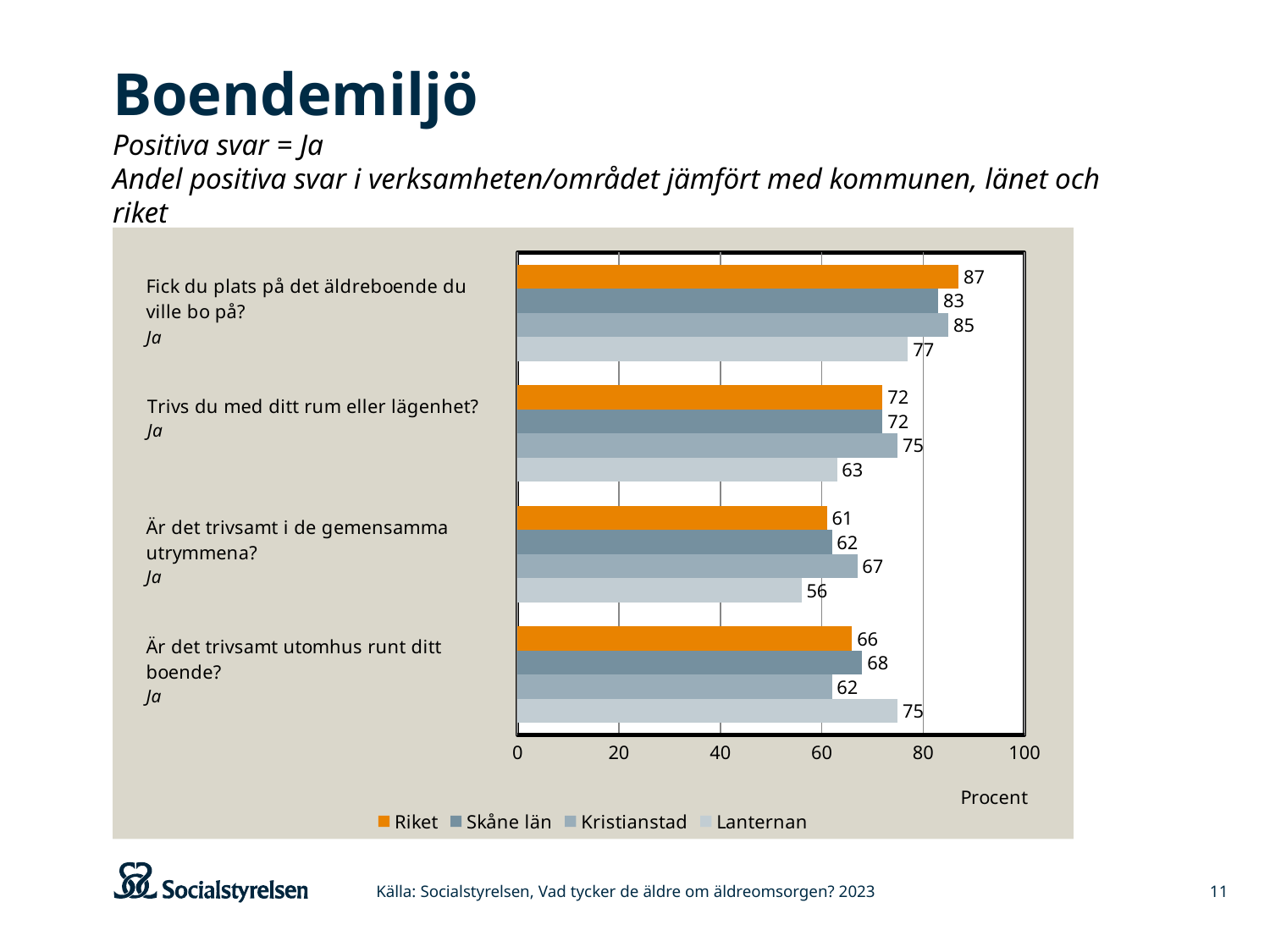
Which series has the highest value on "Fick du plats på det äldreboende du ville bo på?"? Riket What is the label shown on the horizontal axis of the chart? Procent What is the value for Skåne län on "Är det trivsamt utomhus runt ditt boende?"? 68 Which is larger on "Är det trivsamt utomhus runt ditt boende?": the value for Lanternan or the value for Kristianstad? Lanternan What kind of chart is shown on the slide? Bar chart How many questions (categories) are shown on the chart? 4 What is the difference between the Riket and Lanternan values on "Fick du plats på det äldreboende du ville bo på?"? 10 What is the value for Kristianstad on "Är det trivsamt i de gemensamma utrymmena?"? 67 What is the value for Lanternan on "Fick du plats på det äldreboende du ville bo på?"? 77 Which series has the lowest value on "Är det trivsamt i de gemensamma utrymmena?"? Lanternan What is the value for Riket on "Trivs du med ditt rum eller lägenhet?"? 72 How many series does the legend list? 4